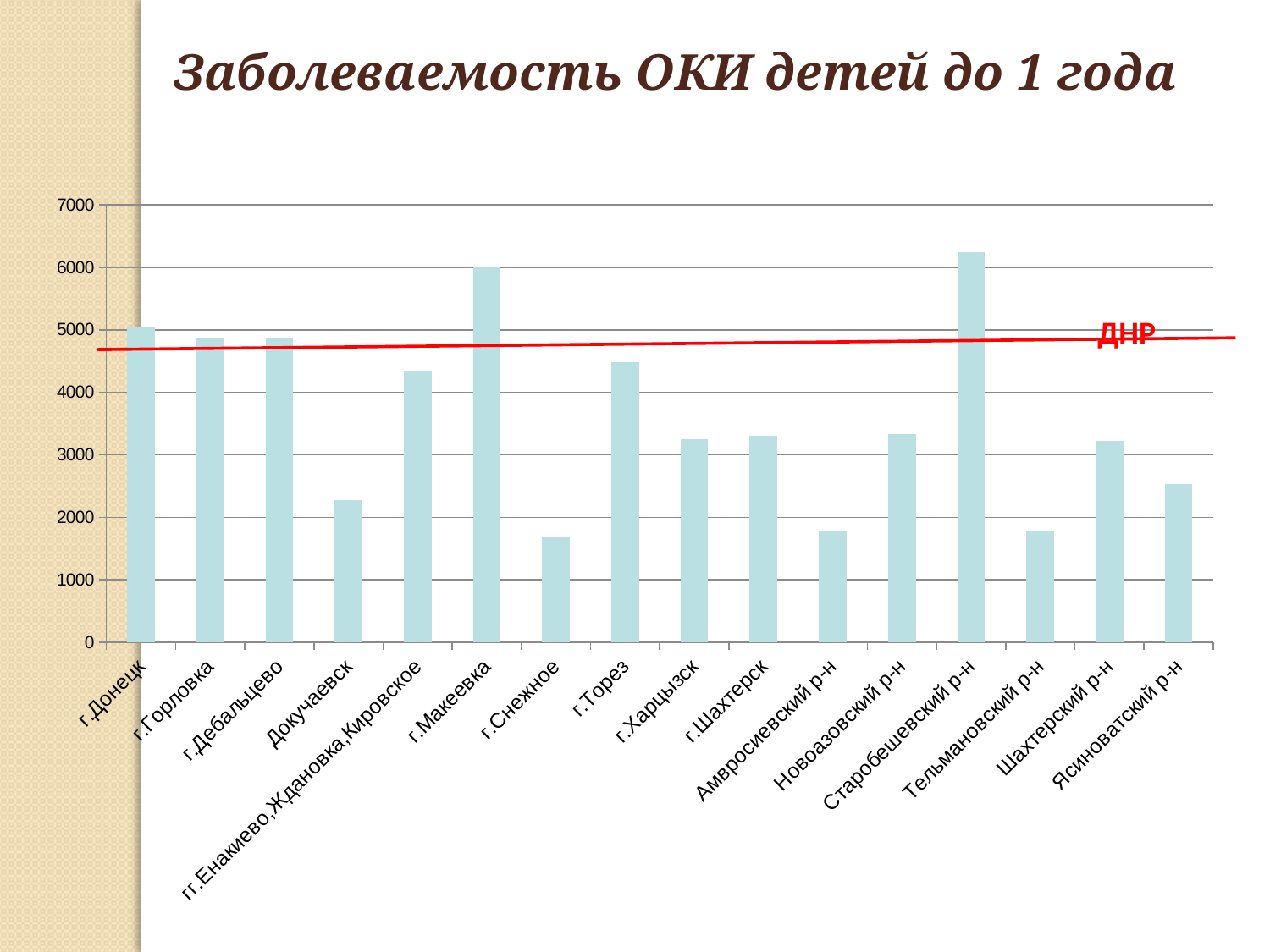
What kind of chart is shown on the slide? bar chart Which category has the highest bar in the chart? Старобешевский р-н How many categories are shown on the x axis of the chart? 16 What is the title of the chart? Заболеваемость ОКИ детей до 1 года Which has the larger value, г.Харцызск or Амвросиевский р-н? г.Харцызск What label is attached to the red line on the chart? ДНР Which has the larger value, г.Макеевка or г.Торез? г.Макеевка Is the value for г.Снежное greater or less than 2000? less Is the value for Старобешевский р-н greater or less than 6000? greater Is the value for г.Торез greater or less than 5000? less